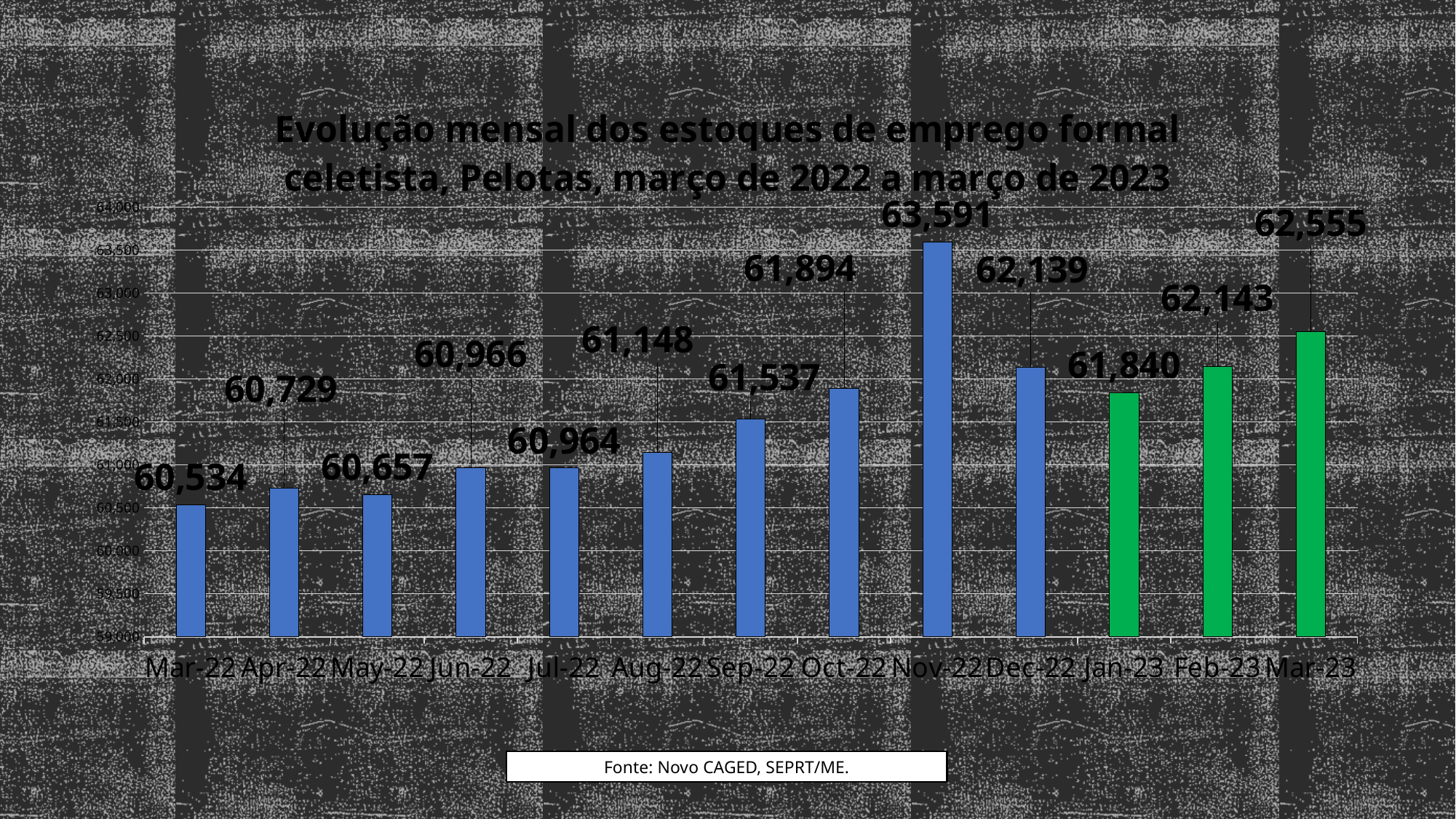
Which month has the highest value? Nov-22 What is the value for Mar-23? 62,555 Which is larger, the value for Sep-22 or the value for Jan-23? Jan-23 Which month has the lowest value? Mar-22 What is the difference between the values for Mar-23 and Mar-22? 2,021 What is the value for Nov-22? 63,591 Do the values generally rise or fall from Mar-22 to Nov-22? Rise How many months are shown on the x axis? 13 What is the value for Aug-22? 61,148 What colour are the bars for Jan-23, Feb-23 and Mar-23? Green What kind of chart is shown on the slide? Bar chart What is the difference between the values for Nov-22 and Dec-22? 1,452